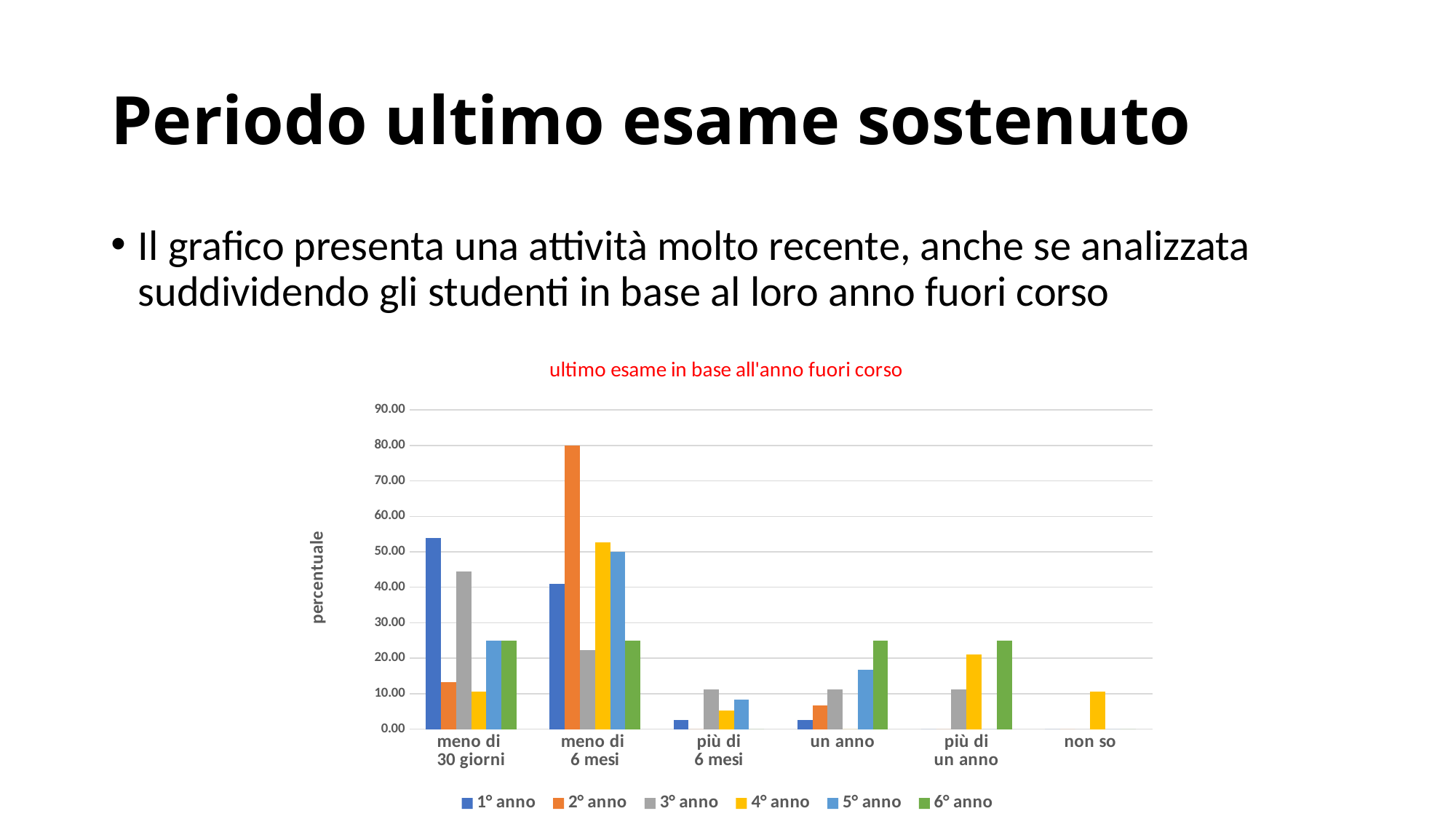
What is the value for 2° anno in the 'meno di 6 mesi' category? 80.00 What is the label of the vertical axis? percentuale Is the value for 1° anno in 'meno di 30 giorni' greater or less than 50.00? greater Which category contains the tallest bar in the chart? meno di 6 mesi Is the value for 3° anno in 'meno di 30 giorni' greater or less than 40.00? greater How many categories are shown on the x axis? 6 Is the value for 4° anno in 'non so' greater or less than 20.00? less What kind of chart is shown on the slide? bar chart What is the title of the chart? ultimo esame in base all'anno fuori corso How many series does the legend list? 6 Which series has the highest value in the 'meno di 6 mesi' category? 2° anno In the 'meno di 30 giorni' category, which is larger: 1° anno or 2° anno? 1° anno